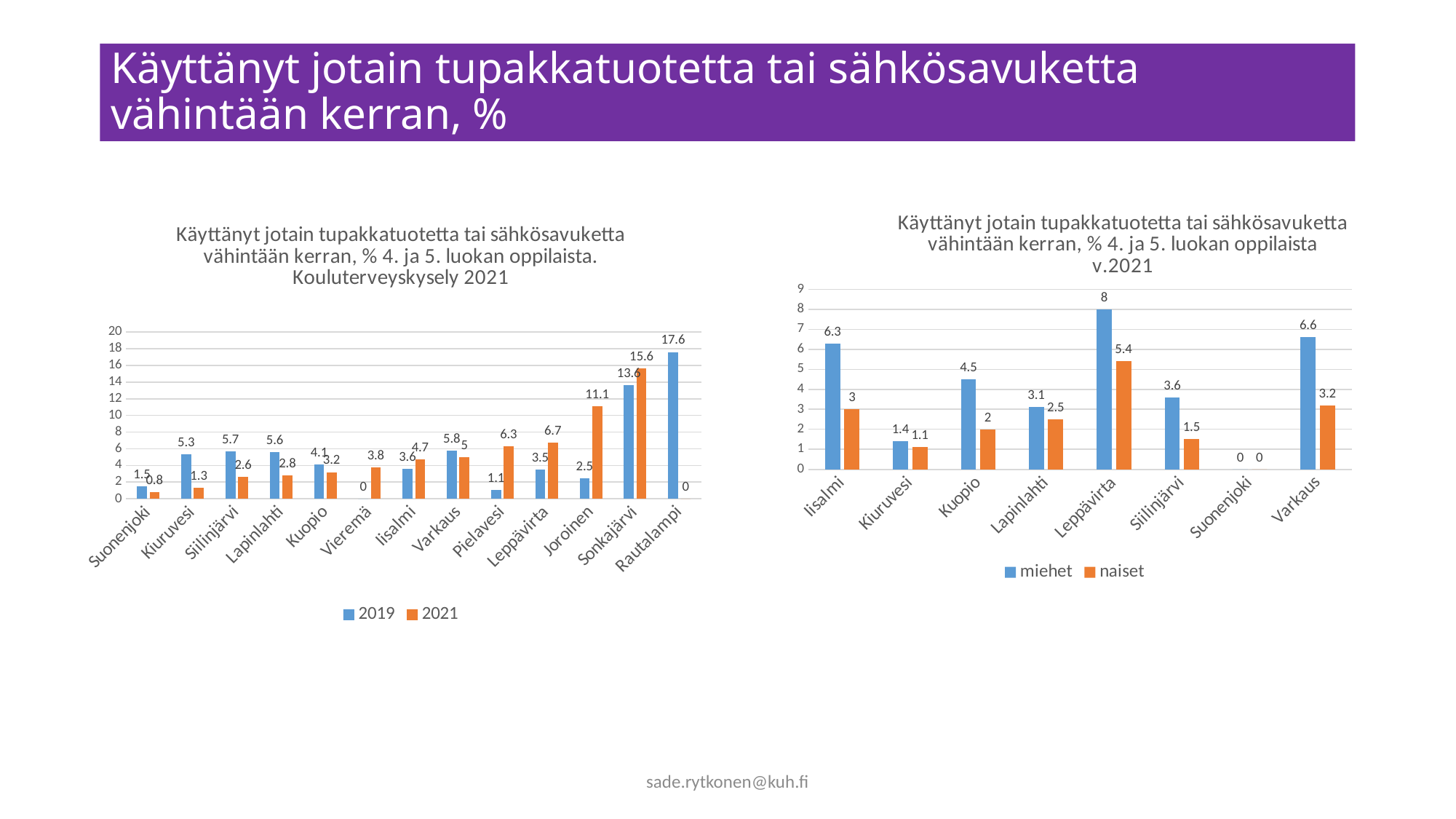
What type of chart is the right chart? Bar chart In the right chart, what is the difference between the miehet and naiset values for Iisalmi? 3.3 In the left chart, which is larger for Pielavesi: the 2019 value or the 2021 value? 2021 In the right chart (v.2021), what is the miehet value for Leppävirta? 8 In the right chart, which municipality has the lowest miehet value? Suonenjoki In the left chart, which municipality has the highest 2021 value? Sonkajärvi How many series does the legend of the right chart list? 2 In the left chart, what is the difference between the 2021 and 2019 values for Sonkajärvi? 2 How many municipalities are shown on the x axis of the left chart? 13 In the right chart, what is the naiset value for Varkaus? 3.2 In the left chart, what is the 2019 value for Rautalampi? 17.6 In the left chart (Kouluterveyskysely 2021), what is the 2021 value for Joroinen? 11.1